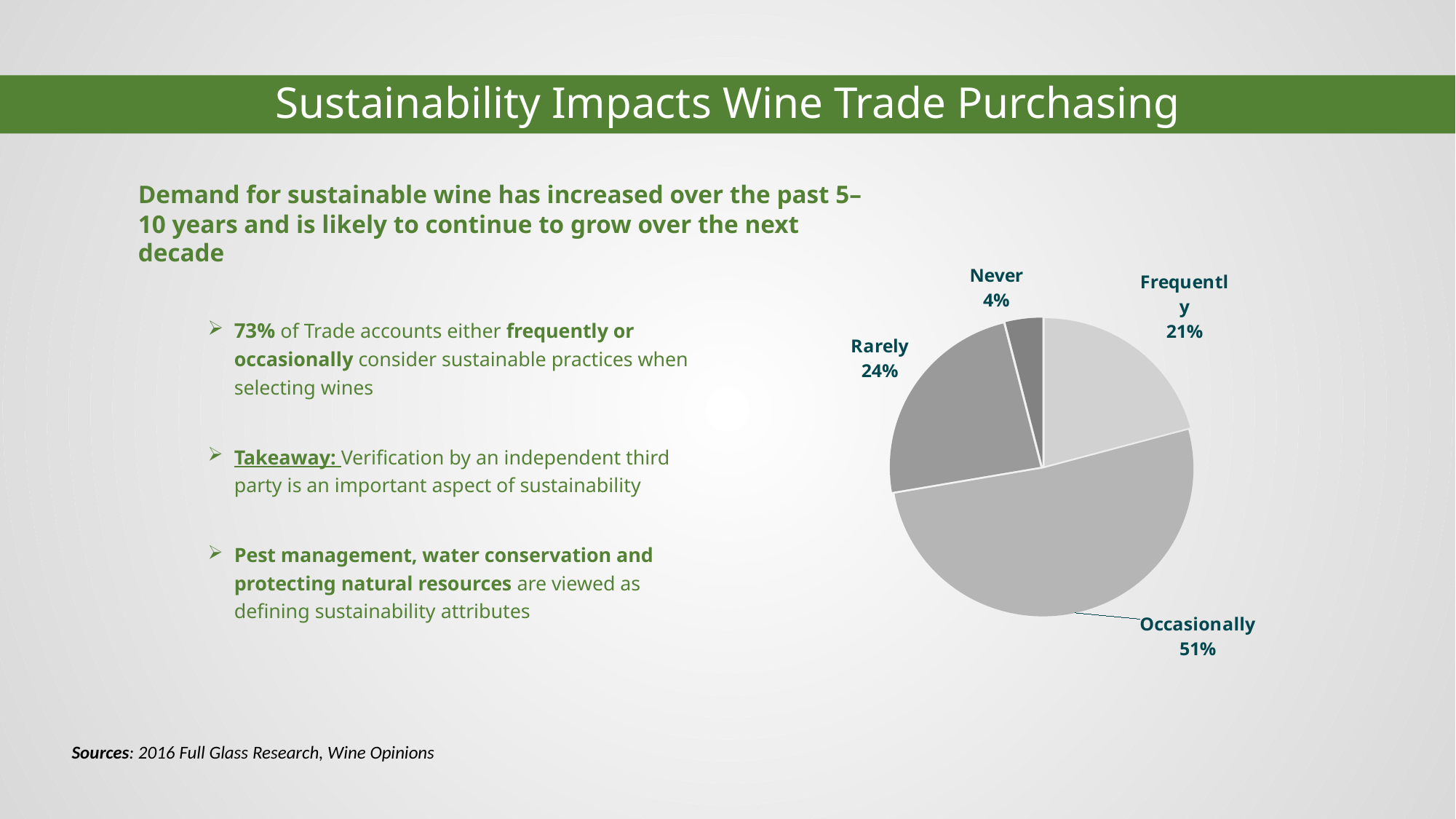
What is the difference between the Occasionally and Frequently shares? 30% What share of the pie is labelled Rarely? 24% Which slice of the pie chart is the largest? Occasionally What share of the pie is labelled Frequently? 21% Which slice of the pie chart is shaded darkest? Never What share of the pie is labelled Occasionally? 51% Which is larger, the Rarely slice or the Frequently slice? Rarely What share of the pie is labelled Never? 4% Which slice of the pie chart is the smallest? Never How many slices does the pie chart have? 4 What kind of chart is shown on the slide? pie chart What is the combined share of the Frequently and Occasionally slices? 72%